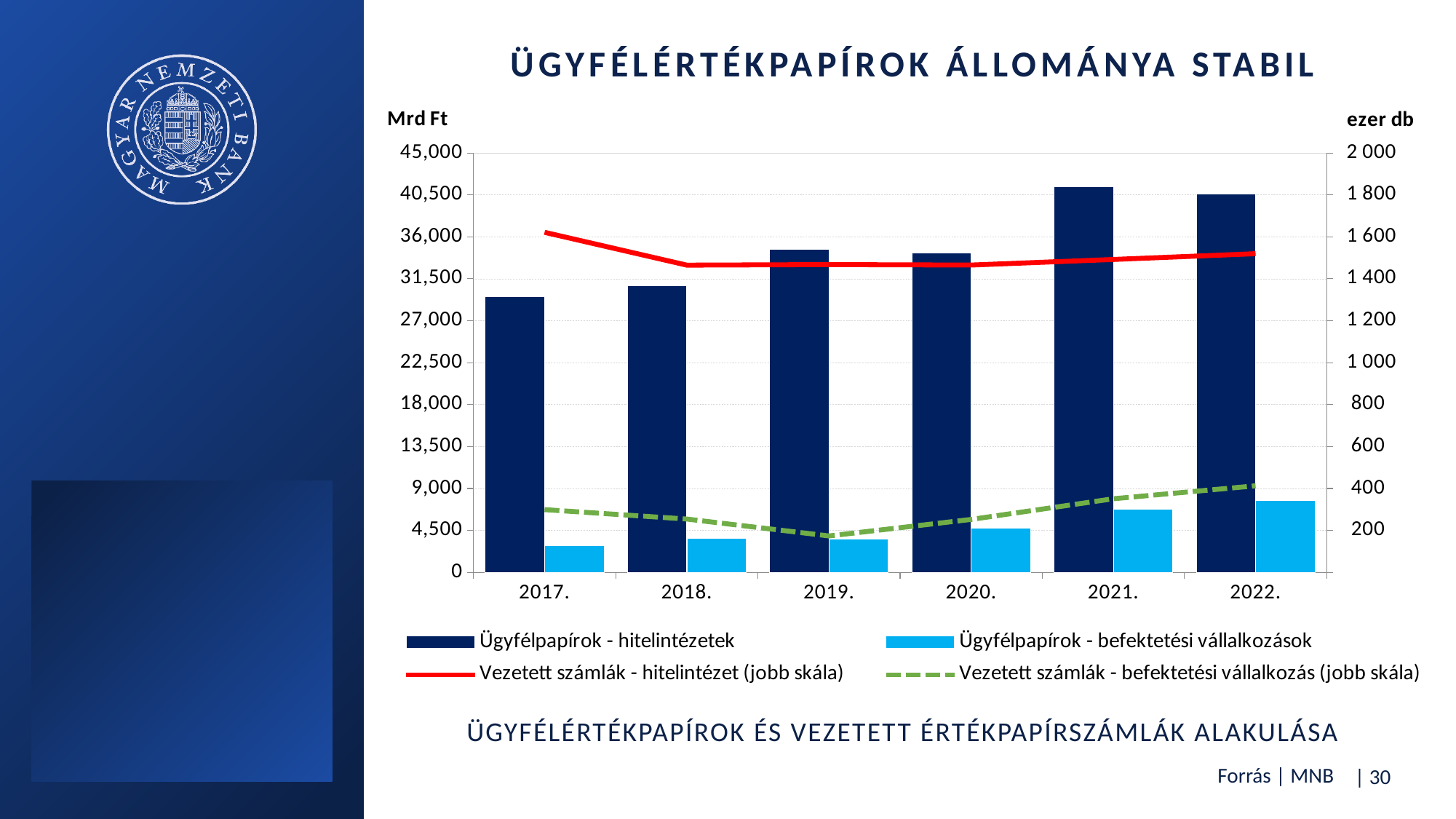
Which is larger in 2019: the 'Ügyfélpapírok - hitelintézetek' bar or the 'Ügyfélpapírok - befektetési vállalkozások' bar? Ügyfélpapírok - hitelintézetek Does the 'Ügyfélpapírok - befektetési vállalkozások' series rise or fall from 2019 to 2022? rise Is the value for 'Ügyfélpapírok - hitelintézetek' in 2021 greater or less than 40,500? greater In which year is the 'Ügyfélpapírok - hitelintézetek' bar the lowest? 2017. How many series does the legend list? 4 In which year is the 'Ügyfélpapírok - hitelintézetek' bar the highest? 2021. What kind of chart is used for the 'Ügyfélpapírok - hitelintézetek' series? bar chart Is the value for 'Ügyfélpapírok - befektetési vállalkozások' in 2017 greater or less than 4,500? less How many years are shown on the x axis of the chart? 6 What unit is shown on the right-hand axis of the chart? ezer db In which year is the 'Ügyfélpapírok - befektetési vállalkozások' bar the highest? 2022.